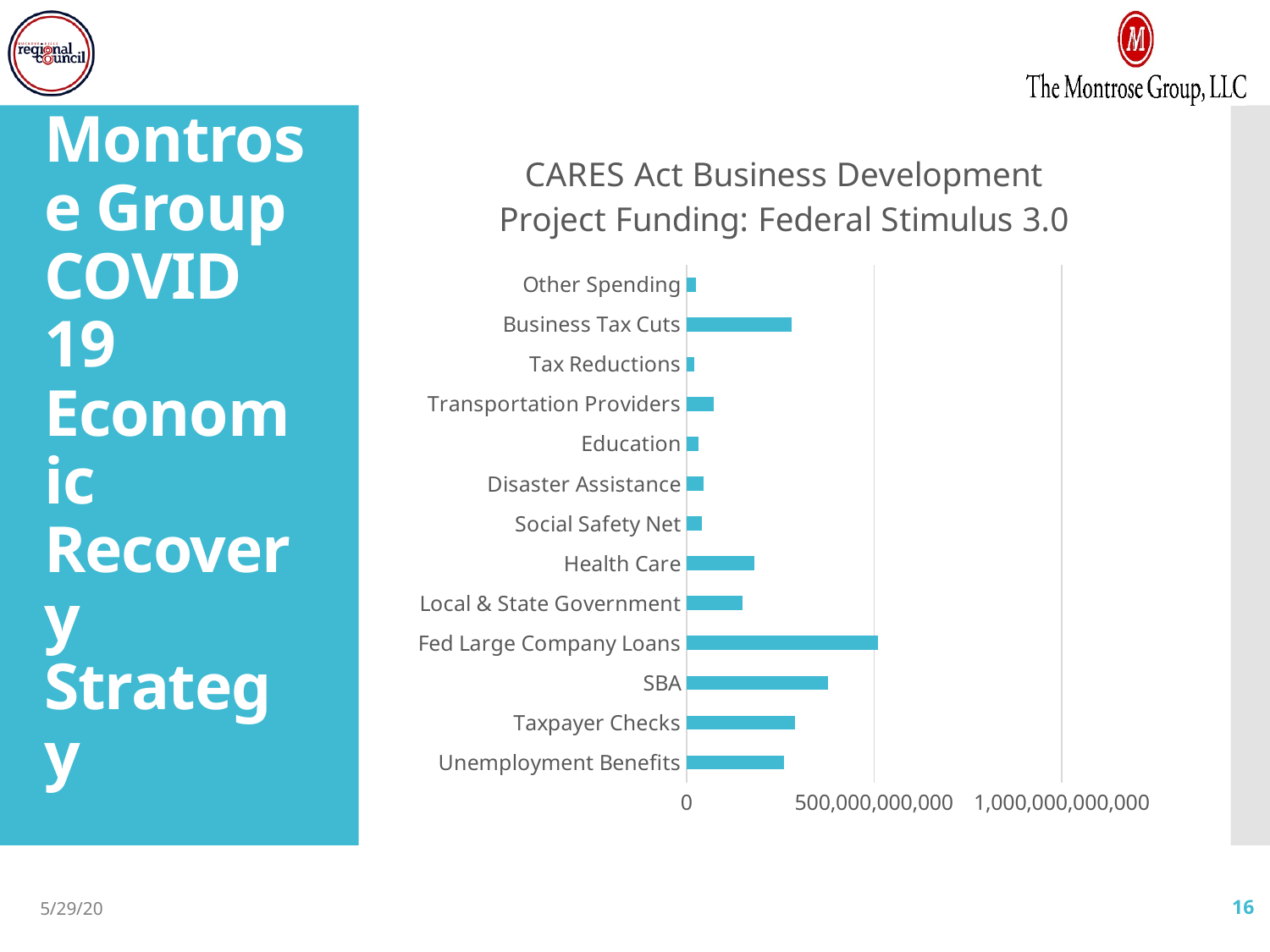
Which is larger, the value for SBA or the value for Taxpayer Checks? SBA Is the value for Business Tax Cuts greater or less than 500,000,000,000? less What is the largest value shown on the horizontal axis of the chart? 1,000,000,000,000 Is the value for Health Care greater or less than 500,000,000,000? less How many categories are plotted in the chart? 13 Is the value for SBA greater or less than 500,000,000,000? less Which category has the highest value in the chart? Fed Large Company Loans What is the title of the chart? CARES Act Business Development Project Funding: Federal Stimulus 3.0 Which is larger, the value for Unemployment Benefits or the value for Health Care? Unemployment Benefits Which is larger, the value for Business Tax Cuts or the value for Transportation Providers? Business Tax Cuts What kind of chart is shown on the slide? bar chart